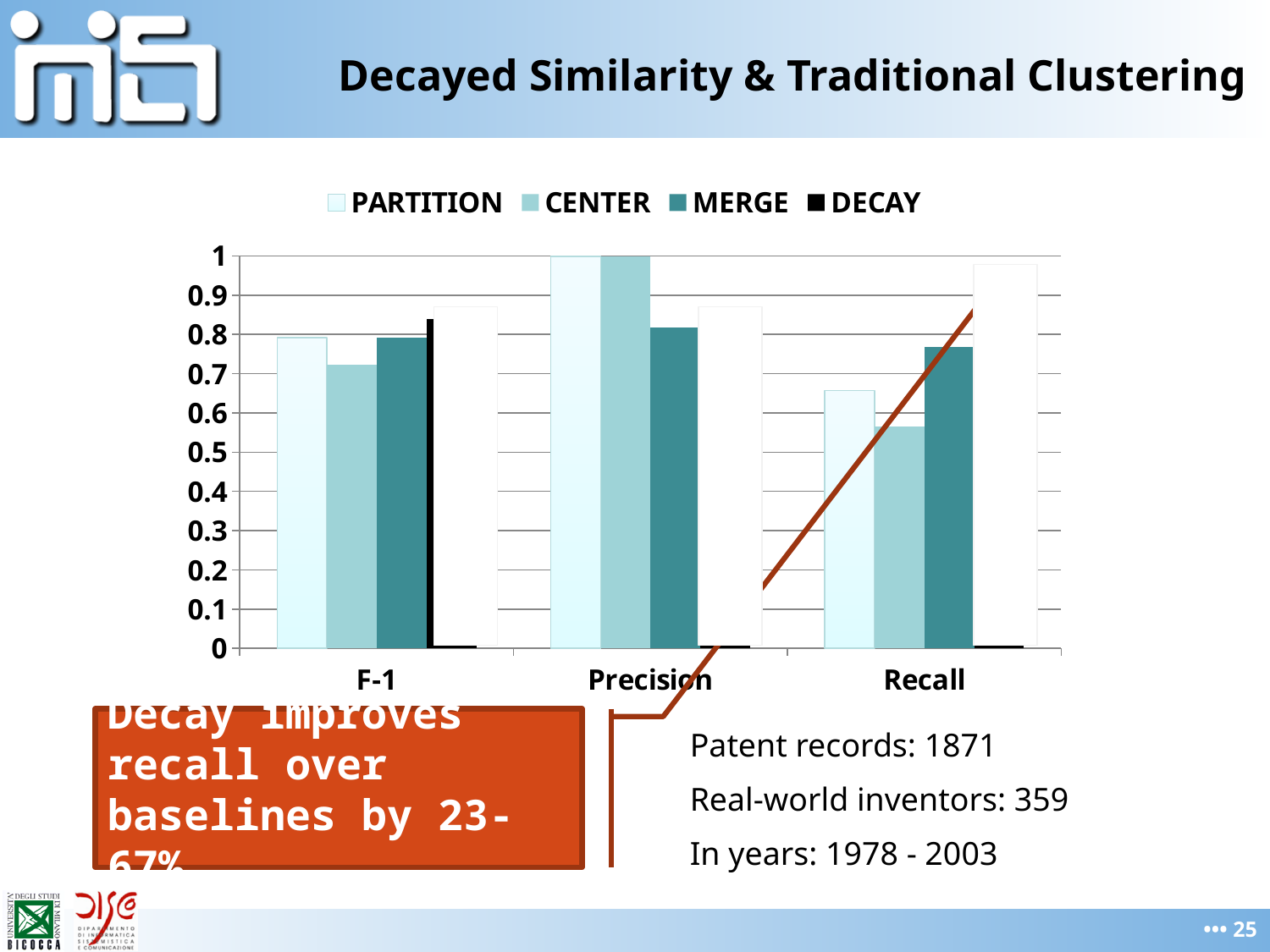
What is the PARTITION value for Precision? 1 How many series does the legend list? 4 What kind of chart is shown on the slide? bar chart What is the CENTER value for Precision? 1 Is the MERGE value for Recall greater or less than 0.7? greater For F-1, which is larger: the PARTITION value or the CENTER value? PARTITION Is the MERGE value for Precision greater or less than 0.9? less Which series are listed in the legend? PARTITION, CENTER, MERGE, DECAY For Recall, which is larger: the MERGE value or the CENTER value? MERGE How many categories are shown on the x axis? 3 Is the CENTER value for F-1 greater or less than 0.8? less Among PARTITION, CENTER and MERGE, which series has the lowest value for Recall? CENTER